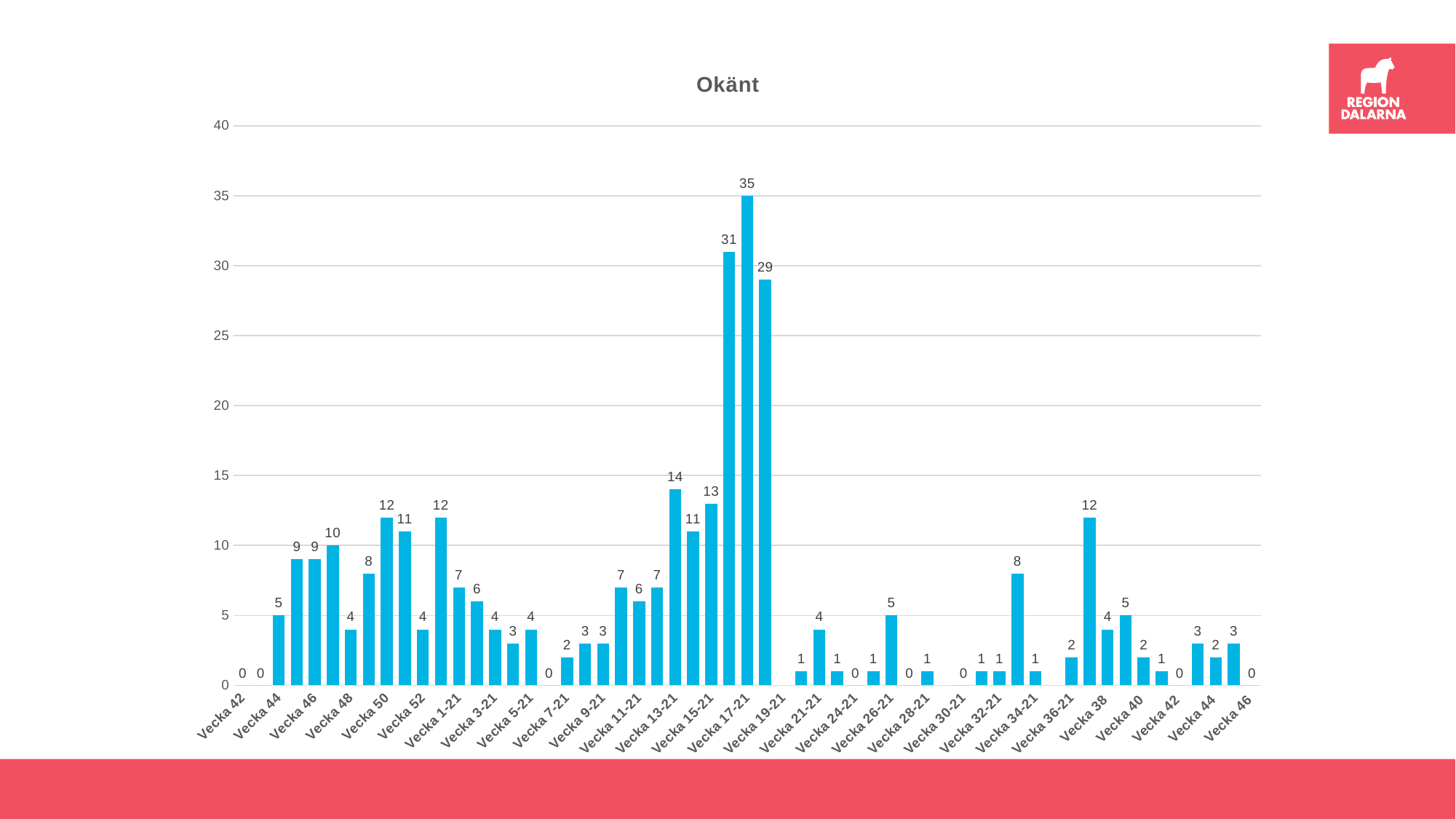
What is the highest value shown in the chart? 35 Is the value for Vecka 13-21 greater or less than 10? greater Is the value for Vecka 17-21 greater or less than 30? greater What is the value for Vecka 17-21? 35 What is the value for Vecka 50? 12 What is the title of the chart? Okänt What is the value for Vecka 26-21? 5 Which is larger, the value for Vecka 50 or the value for Vecka 38? Vecka 50 What is the maximum value shown on the vertical axis? 40 What kind of chart is shown on the slide? bar chart What is the difference between the two tallest bars in the chart (35 and 31)? 4 What is the value for Vecka 13-21? 14